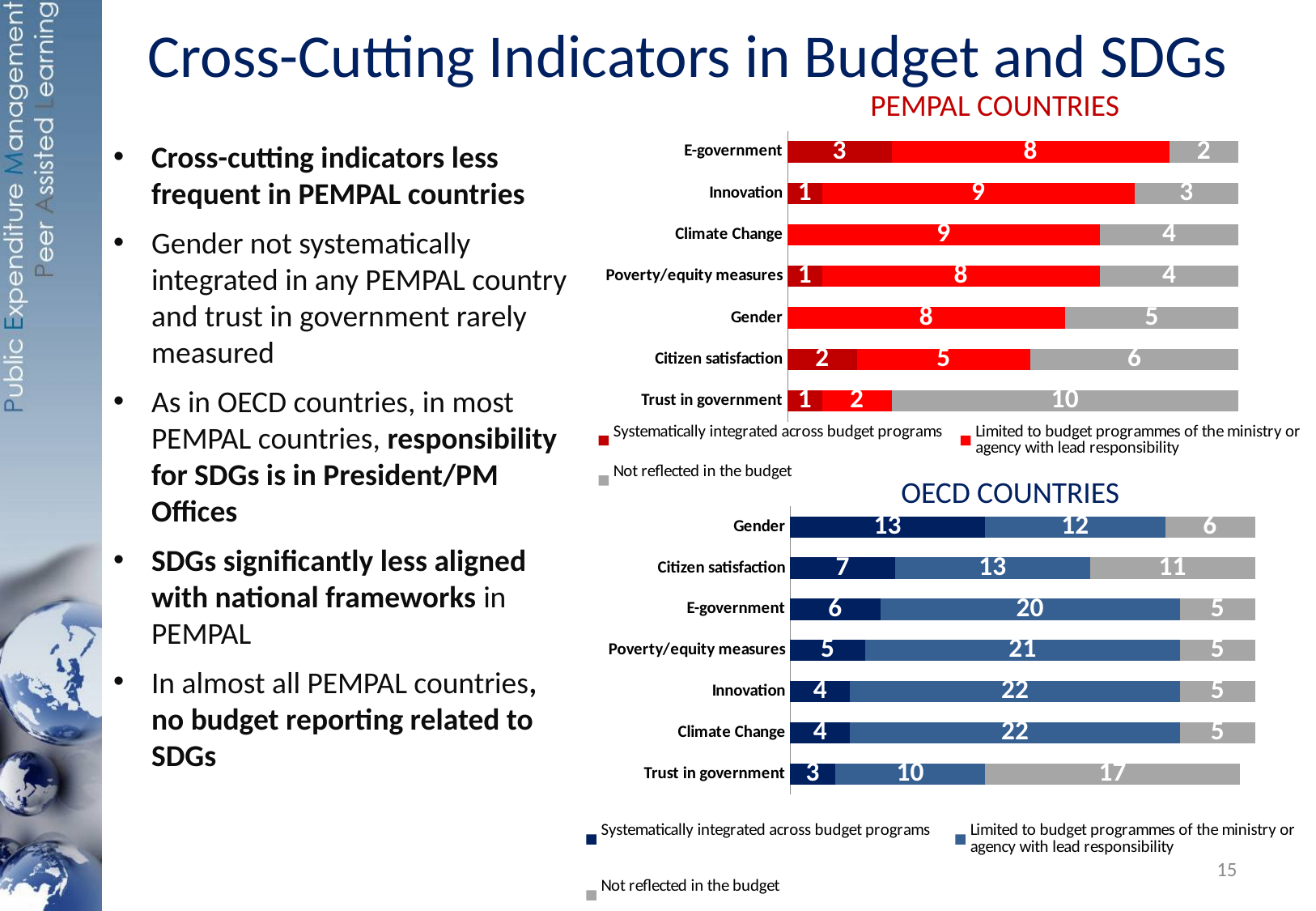
In the OECD COUNTRIES chart, which category has the highest value for 'Systematically integrated across budget programs'? Gender In the OECD COUNTRIES chart, what is the value of 'Limited to budget programmes of the ministry or agency with lead responsibility' for Poverty/equity measures? 21 In the OECD COUNTRIES chart, what is the total of the stacked bar for Gender? 31 In the PEMPAL COUNTRIES chart, which category has the highest value for 'Systematically integrated across budget programs'? E-government In the PEMPAL COUNTRIES chart, how many categories are shown on the vertical axis? 7 In the PEMPAL COUNTRIES chart, what is the value of 'Not reflected in the budget' for Trust in government? 10 In the PEMPAL COUNTRIES chart, what is the total of the stacked bar for Citizen satisfaction? 13 In the OECD COUNTRIES chart, what is the difference between the 'Not reflected in the budget' values for Trust in government and Gender? 11 In the PEMPAL COUNTRIES chart, what is the value of 'Limited to budget programmes of the ministry or agency with lead responsibility' for Innovation? 9 What type of chart is the PEMPAL COUNTRIES chart? Stacked bar chart In the OECD COUNTRIES chart, which category has the highest value for 'Not reflected in the budget'? Trust in government How many series does the legend of the OECD COUNTRIES chart list? 3